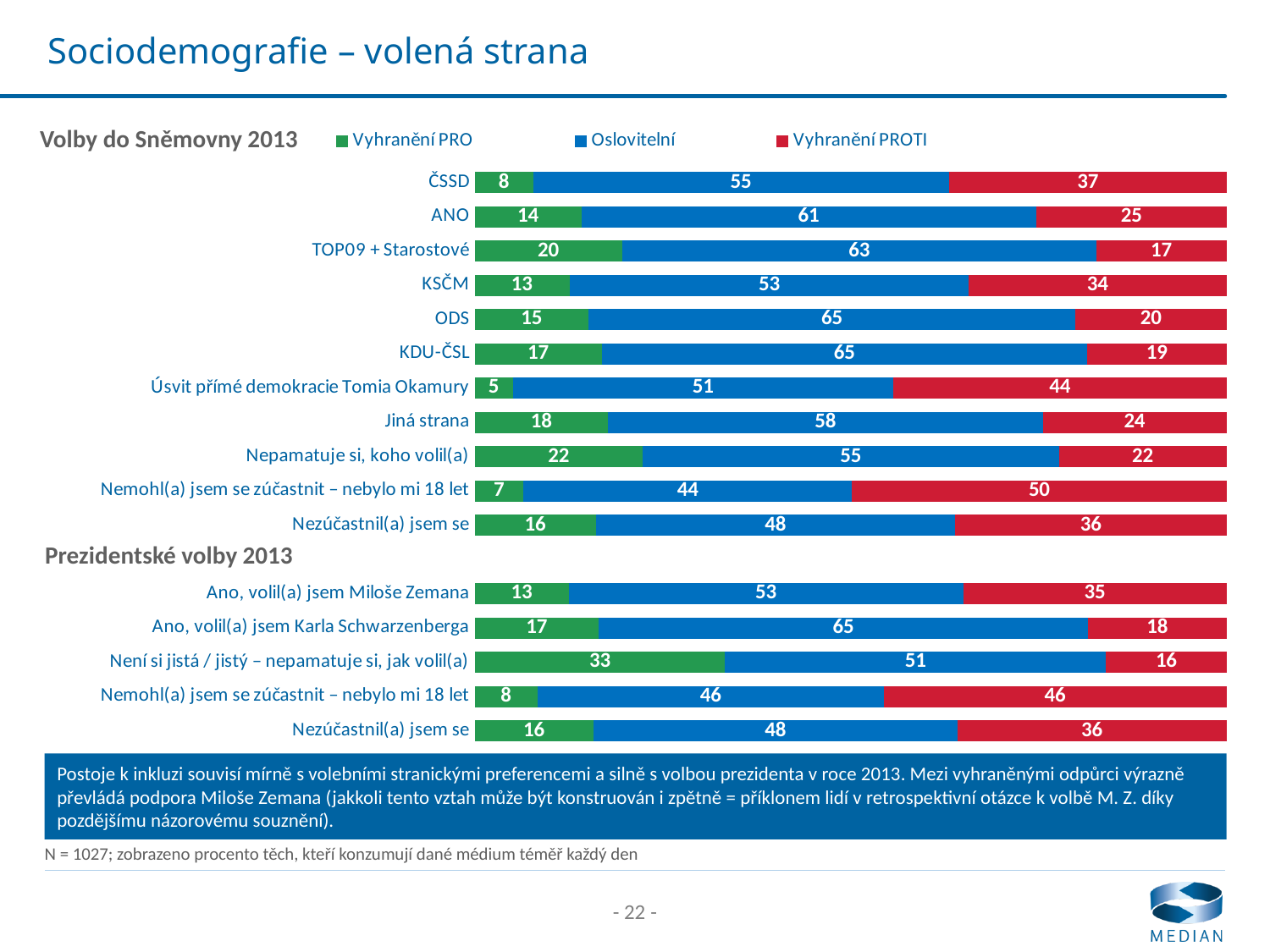
Which category has the lowest Vyhranění PRO value? Úsvit přímé demokracie Tomia Okamury What is the total of the stacked bar for ODS? 100 What is the Vyhranění PRO value for Ano, volil(a) jsem Karla Schwarzenberga? 17 What kind of chart is shown on the slide? Stacked bar chart What is the Vyhranění PROTI value for ČSSD? 37 Which has a larger Vyhranění PROTI value, ANO or KSČM? KSČM Which category has the highest Vyhranění PROTI value? Nemohl(a) jsem se zúčastnit – nebylo mi 18 let (Volby do Sněmovny 2013) Which category has the highest Vyhranění PRO value? Není si jistá / jistý – nepamatuje si, jak volil(a) What is the Oslovitelní value for TOP09 + Starostové? 63 How many series does the legend list? 3 What is the difference between the Vyhranění PROTI and Vyhranění PRO values for ČSSD? 29 How many categories (bars) are plotted in the chart? 16